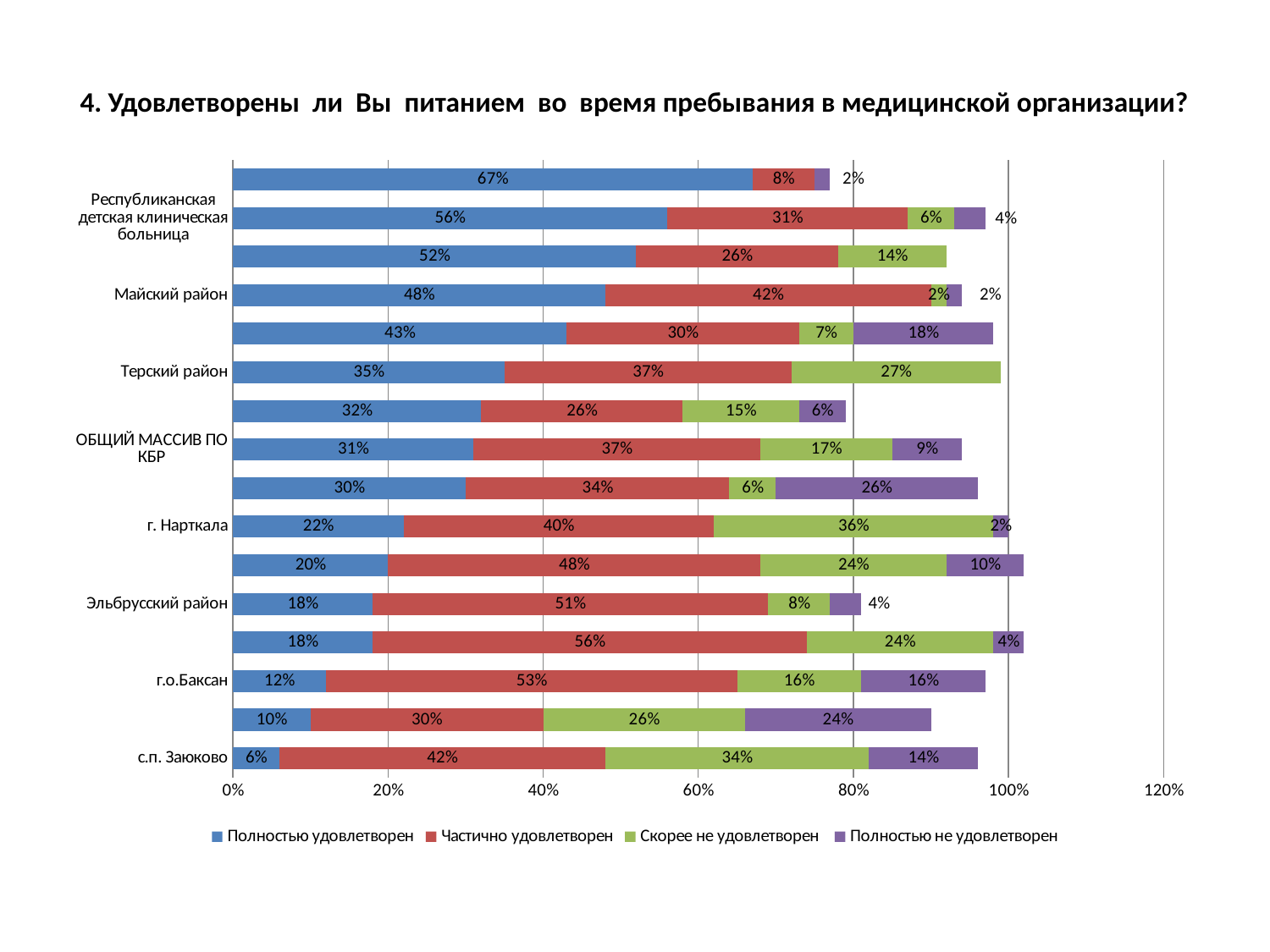
What is the 'Полностью не удовлетворен' value for ОБЩИЙ МАССИВ ПО КБР? 9% What is the 'Частично удовлетворен' value for г.о.Баксан? 53% What is the 'Скорее не удовлетворен' value for г. Нарткала? 36% How many bars are plotted in the chart? 16 What kind of chart is shown on the slide? Stacked bar chart What is the 'Полностью удовлетворен' value for с.п. Заюково? 6% What colour represents the 'Полностью удовлетворен' series? Blue What is the total of the stacked bar for с.п. Заюково? 96% How many series does the legend list? 4 For Эльбрусский район, how much larger is the 'Частично удовлетворен' value than the 'Полностью удовлетворен' value? 33 percentage points Which labelled category has the lowest 'Полностью удовлетворен' value? с.п. Заюково Which has the larger 'Полностью удовлетворен' value, Майский район or Терский район? Майский район